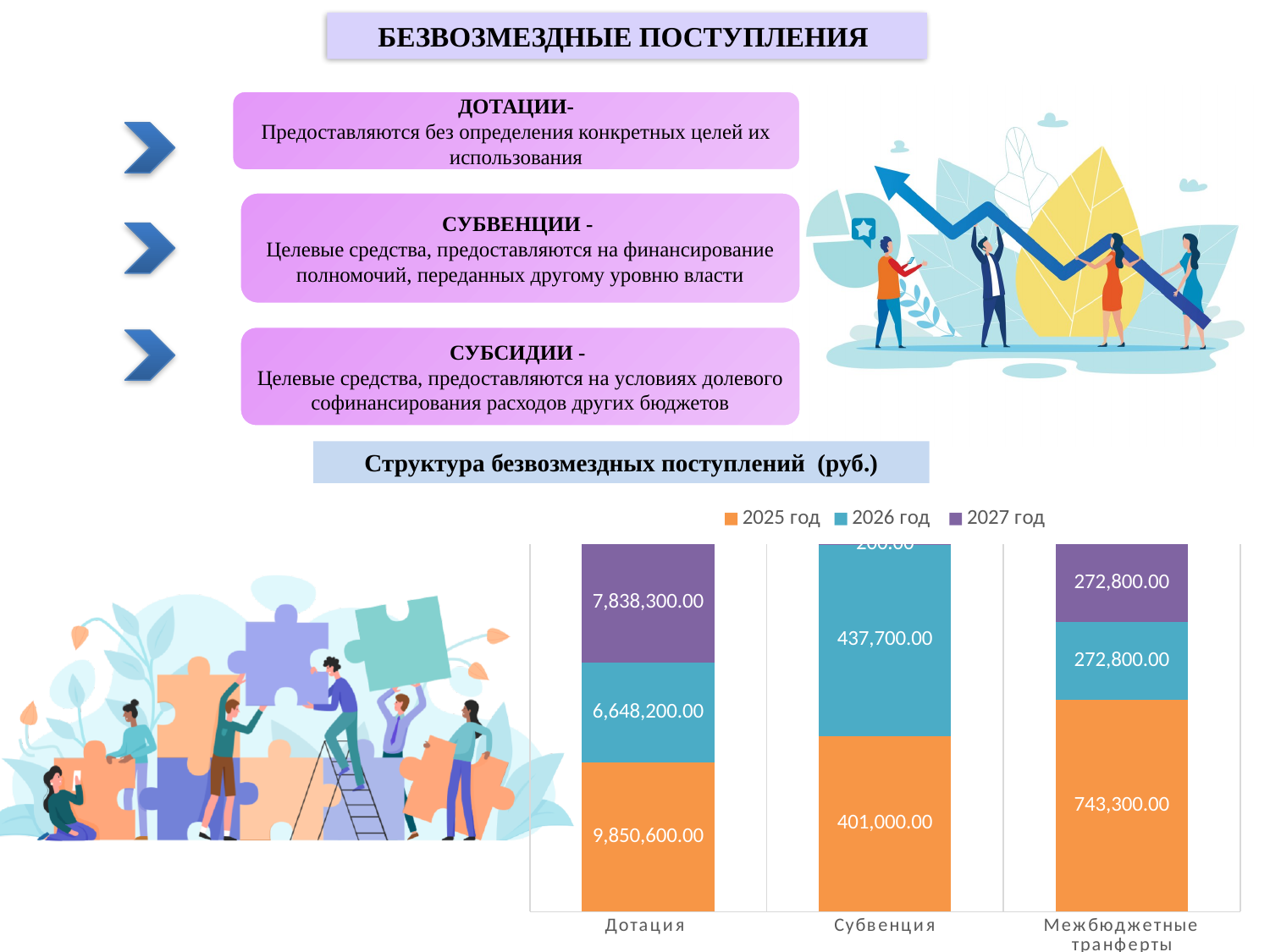
What is the value for Субвенция in the 2026 год series? 437,700.00 For Субвенция, which is larger: the 2025 год value or the 2026 год value? 2026 год How many series does the legend of the chart list? 3 Which year has the highest value for Дотация? 2025 год What is the value for Межбюджетные трансферты in the 2025 год series? 743,300.00 What is the value for Дотация in the 2025 год series? 9,850,600.00 Which year has the lowest value for Дотация? 2026 год What is the total of the stacked bar for Межбюджетные трансферты? 1,288,900.00 How many categories are shown on the x axis of the chart? 3 What is the value for Дотация in the 2027 год series? 7,838,300.00 What kind of chart is shown under the title "Структура безвозмездных поступлений (руб.)"? Stacked bar chart What is the difference between the 2025 год and 2026 год values for Дотация? 3,202,400.00